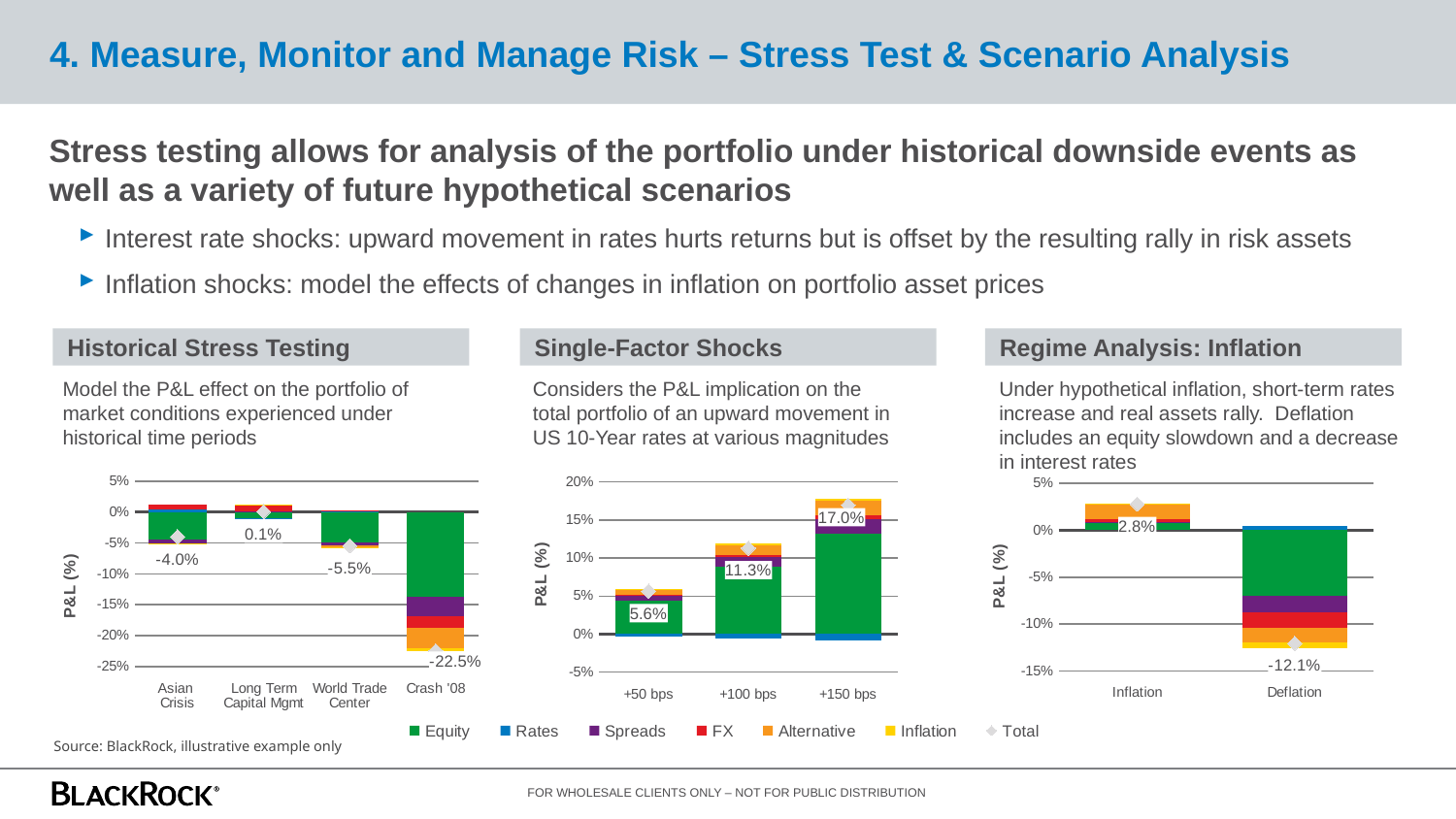
In the Historical Stress Testing chart, what is the total P&L for the Crash '08 scenario? -22.5% In the Single-Factor Shocks chart, what is the total P&L for the +100 bps shock? 11.3% In the Historical Stress Testing chart, what is the difference between the total P&L for World Trade Center and Asian Crisis? 1.5% In the Historical Stress Testing chart, what is the total P&L for the Asian Crisis scenario? -4.0% In the Single-Factor Shocks chart, what is the difference between the total P&L for +150 bps and +50 bps? 11.4% How many series does the shared legend below the charts list? 7 In the Historical Stress Testing chart, which scenario has the lowest total P&L? Crash '08 In the Regime Analysis: Inflation chart, which scenario has the larger total P&L, Inflation or Deflation? Inflation How many scenarios are shown on the x axis of the Historical Stress Testing chart? 4 In the Regime Analysis: Inflation chart, what is the total P&L for the Deflation scenario? -12.1% In the Historical Stress Testing chart, which scenario has the highest total P&L? Long Term Capital Mgmt In the Single-Factor Shocks chart, do the total P&L values rise or fall as the shock size increases from +50 bps to +150 bps? rise